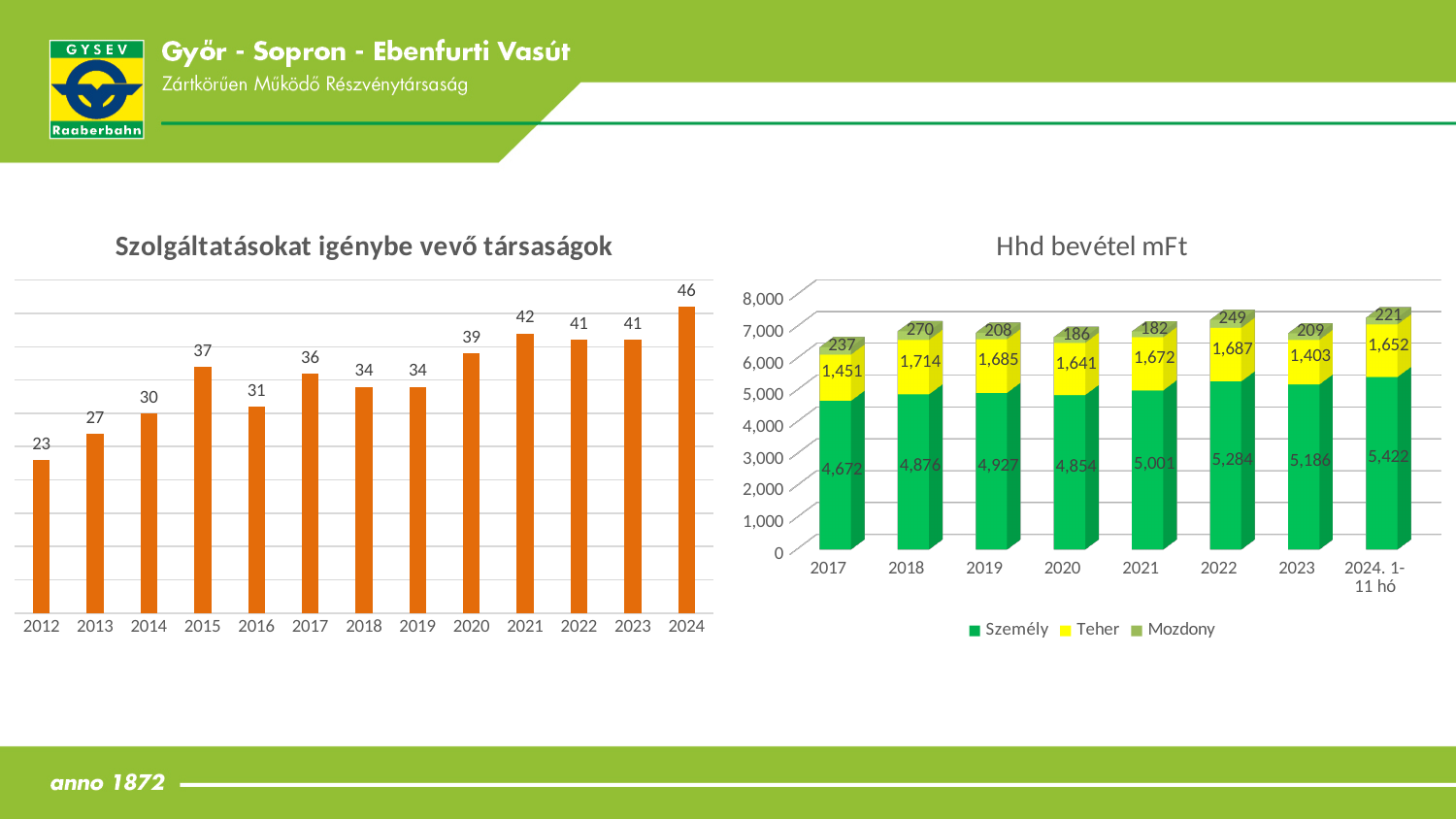
In the chart titled "Szolgáltatásokat igénybe vevő társaságok", how many years are shown on the x axis? 13 In the chart titled "Hhd bevétel mFt", what is the total of the stacked bar for 2017? 6,360 In the chart titled "Hhd bevétel mFt", what is the Teher value for 2018? 1,714 In the chart titled "Szolgáltatásokat igénybe vevő társaságok", what is the difference between the values for 2024 and 2012? 23 In the chart titled "Hhd bevétel mFt", which year has the highest Személy value? 2024. 1-11 hó What kind of chart is the chart titled "Hhd bevétel mFt"? Stacked bar chart In the chart titled "Hhd bevétel mFt", how many series does the legend list? 3 In the chart titled "Szolgáltatásokat igénybe vevő társaságok", which is larger, the value for 2015 or the value for 2016? 2015 In the chart titled "Hhd bevétel mFt", what is the Mozdony value for 2021? 182 In the chart titled "Szolgáltatásokat igénybe vevő társaságok", which year has the lowest value? 2012 In the chart titled "Hhd bevétel mFt", what is the Személy value for 2023? 5,186 In the chart titled "Szolgáltatásokat igénybe vevő társaságok", what is the value for 2024? 46